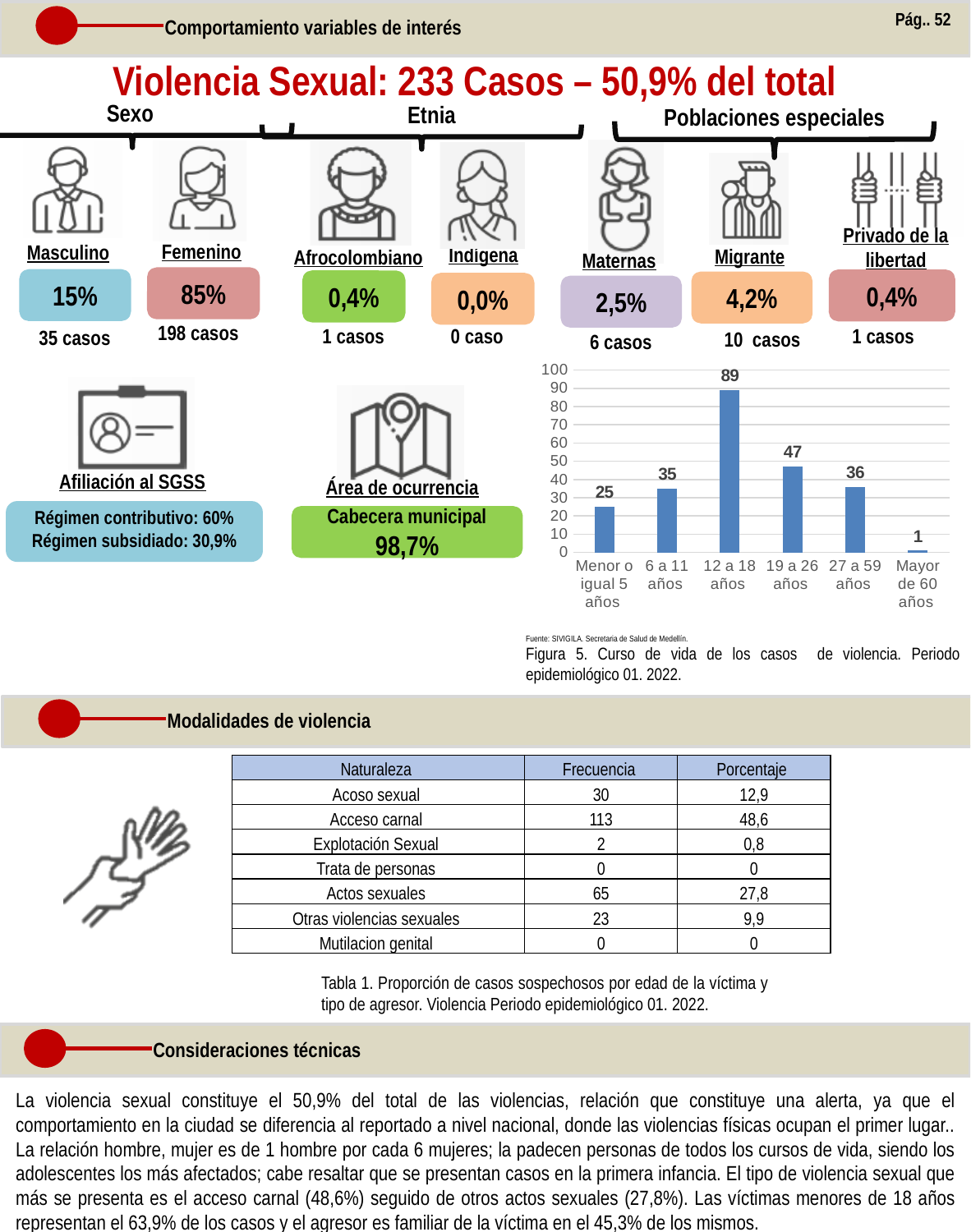
What is the difference between the values for 6 a 11 años and Menor o igual 5 años in the bar chart? 10 What is the value for the Menor o igual 5 años age group in the bar chart? 25 What is the value for the 12 a 18 años age group in the bar chart? 89 What is the difference between the values for 12 a 18 años and 19 a 26 años in the bar chart? 42 How many age groups are shown in the bar chart? 6 Is the value for 19 a 26 años in the bar chart greater or less than 40? greater Which age group has the highest value in the bar chart? 12 a 18 años What is the maximum value shown on the vertical axis of the bar chart? 100 What is the value for the 27 a 59 años age group in the bar chart? 36 What kind of chart is used to show cases by age group (curso de vida)? bar chart In the bar chart, which is larger: the value for 19 a 26 años or the value for 27 a 59 años? 19 a 26 años Which age group has the lowest value in the bar chart? Mayor de 60 años